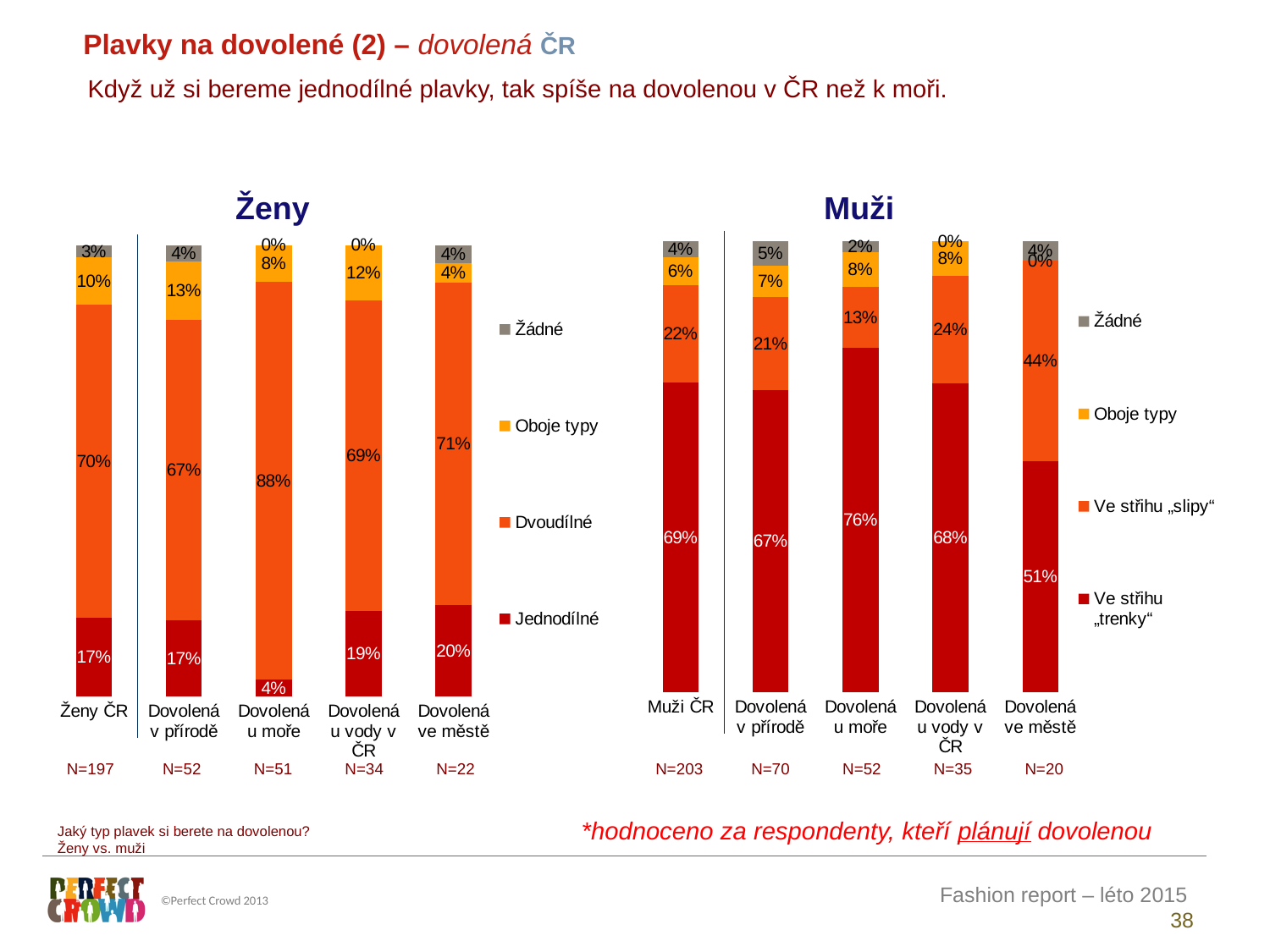
How many categories are shown on the x axis of the Muži chart? 5 How many series does the legend of the Ženy chart list? 4 In the Ženy chart, which category has the lowest Jednodílné value? Dovolená u moře In the Muži chart, what is the difference between the Ve střihu „trenky“ values for Dovolená u moře and Dovolená ve městě? 25% In the Ženy chart, which category has the highest Dvoudílné value? Dovolená u moře What type of chart is the Ženy chart? Stacked bar chart In the Ženy chart, what is the Jednodílné value for Dovolená u moře? 4% In the Muži chart, what is the Ve střihu „slipy“ value for Dovolená ve městě? 44% In the Ženy chart, what is the Dvoudílné value for Dovolená ve městě? 71% In the Muži chart, which is larger: the Ve střihu „trenky“ value for Dovolená ve městě or for Muži ČR? Muži ČR In the Ženy chart, what is the difference between the Dvoudílné values for Dovolená u moře and Ženy ČR? 18% In the Muži chart, which category has the highest Ve střihu „trenky“ value? Dovolená u moře